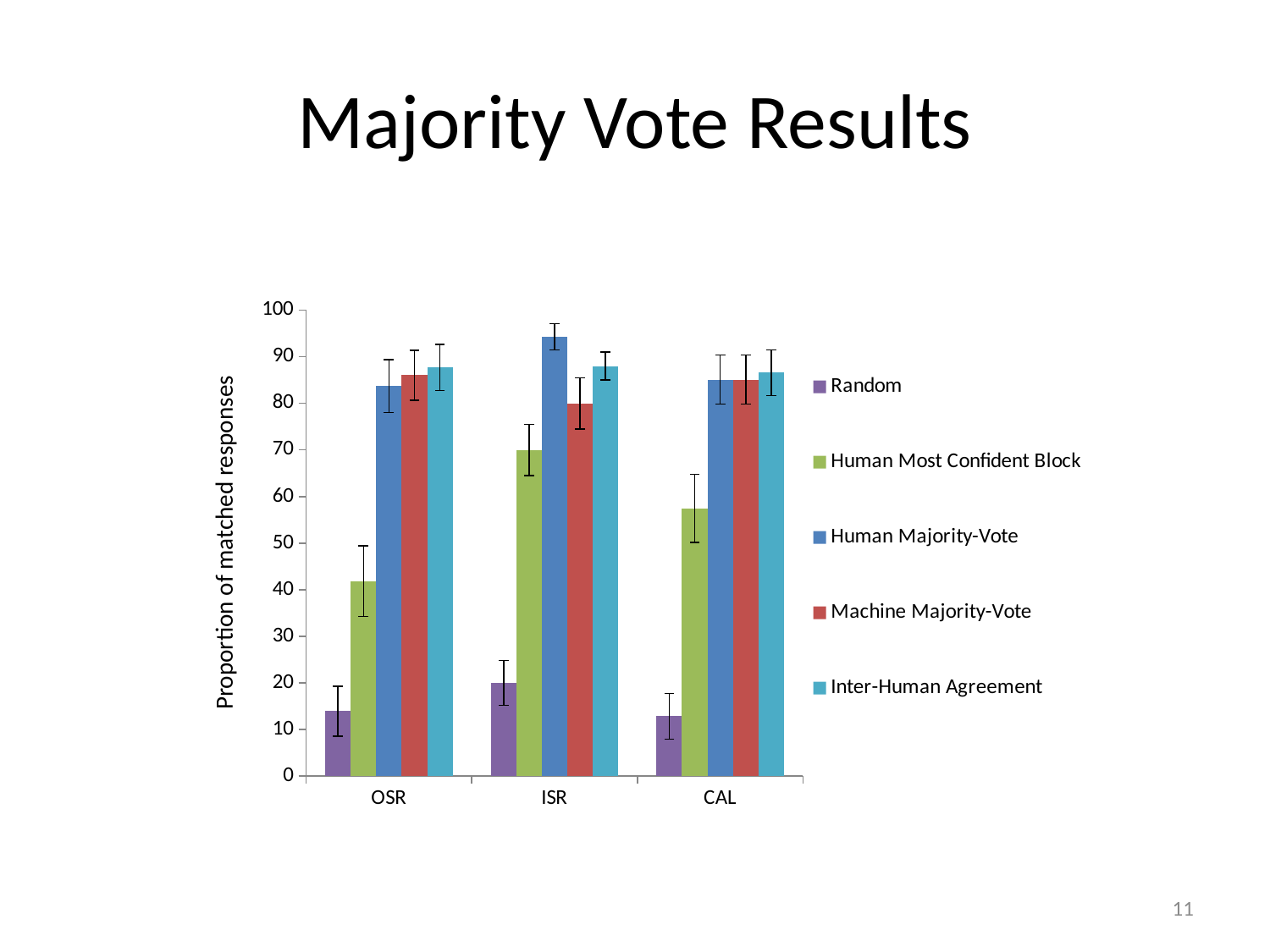
Is the value for Human Most Confident Block in the OSR category greater or less than 50? less How many categories are shown on the x axis of the chart? 3 What is the label on the vertical axis of the chart? Proportion of matched responses In which category is the Human Most Confident Block value lowest? OSR What kind of chart is shown on the slide? bar chart Is the value for Random in the OSR category greater or less than 20? less Is the value for Human Majority-Vote in the ISR category greater or less than 90? greater Which series has the lowest value in the CAL category? Random In the ISR category, which is larger: Human Majority-Vote or Machine Majority-Vote? Human Majority-Vote In which category is the Human Majority-Vote value highest? ISR How many series does the chart's legend list? 5